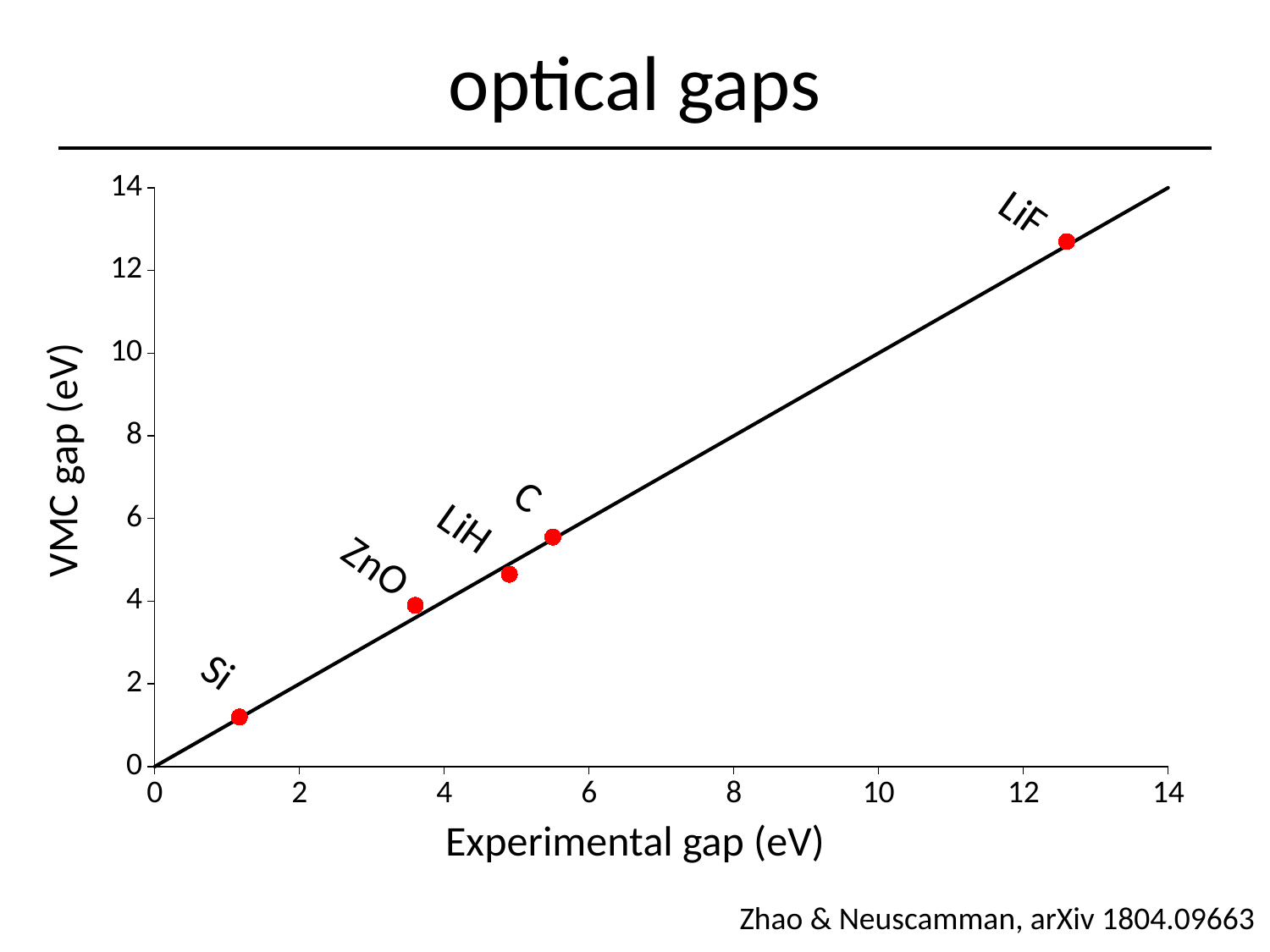
Is the experimental gap for ZnO greater or less than 4 eV? less Which has a larger VMC gap, C or ZnO? C What is the title of the chart? optical gaps Is the VMC gap for C greater or less than 4 eV? greater How many labeled data points are plotted on the chart? 5 Do the VMC gap values rise or fall as the experimental gap increases? rise Which material has the highest VMC gap? LiF What kind of chart is shown on the slide? scatter plot Is the VMC gap for Si greater or less than 2 eV? less Which material has the lowest experimental gap? Si What is the label of the y axis? VMC gap (eV)